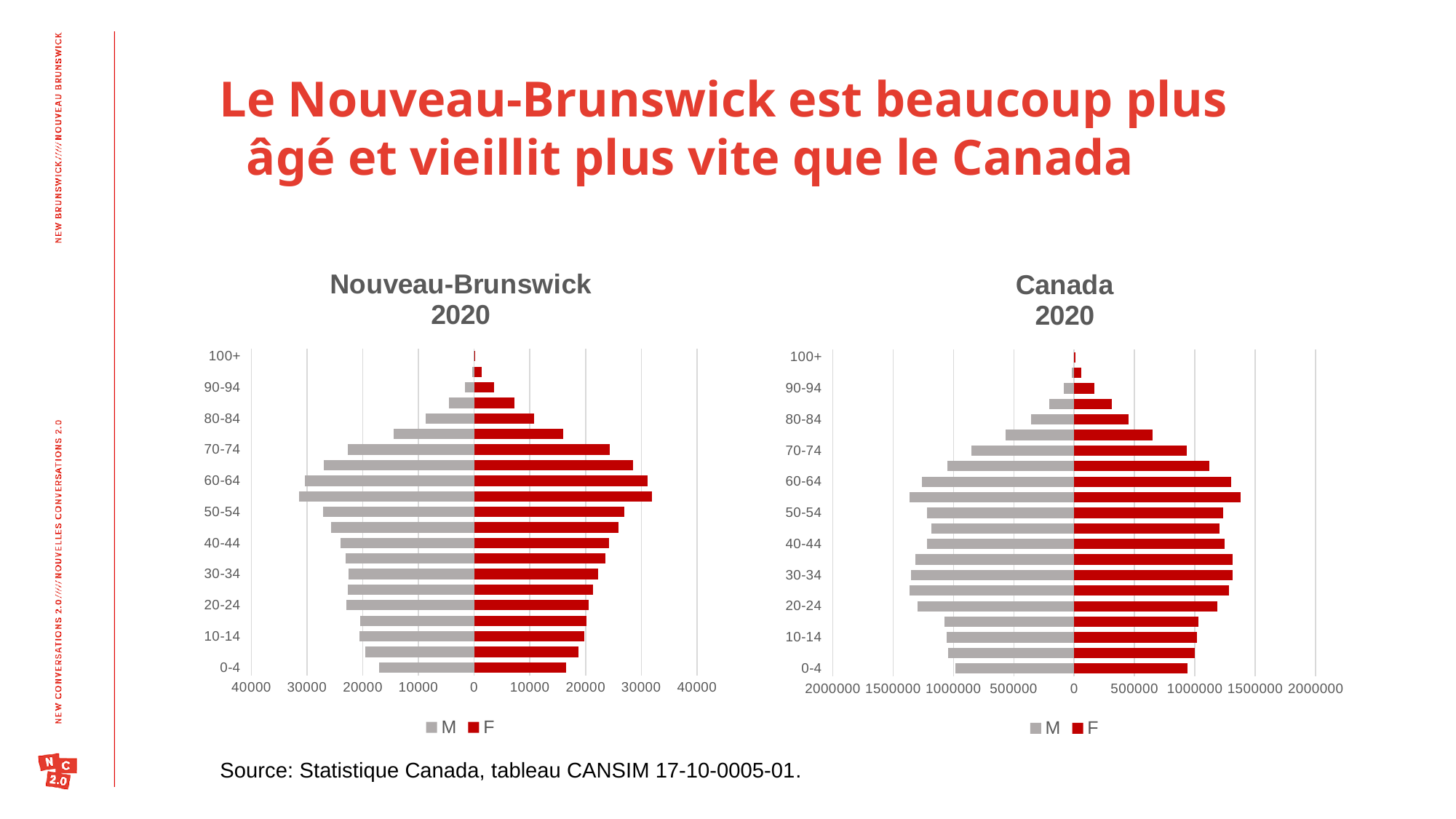
In the Canada 2020 chart, is the M value for the 80-84 age group greater or less than 500000? less In the Nouveau-Brunswick 2020 chart, for the 80-84 age group, which series has the larger value: M or F? F In the Nouveau-Brunswick 2020 chart, is the F value for the 70-74 age group greater or less than 20000? greater In the Nouveau-Brunswick 2020 chart, which is larger for the F series: the 60-64 age group or the 0-4 age group? 60-64 In the Canada 2020 chart, which colour represents the F series? red What kind of chart is the Nouveau-Brunswick 2020 chart? bar chart In the Nouveau-Brunswick 2020 chart, is the F value for the 0-4 age group greater or less than 20000? less In the Nouveau-Brunswick 2020 chart, what are the two series named in the legend? M and F In the Canada 2020 chart, which is larger for the F series: the 60-64 age group or the 80-84 age group? 60-64 How many series does the legend of the Canada 2020 chart list? 2